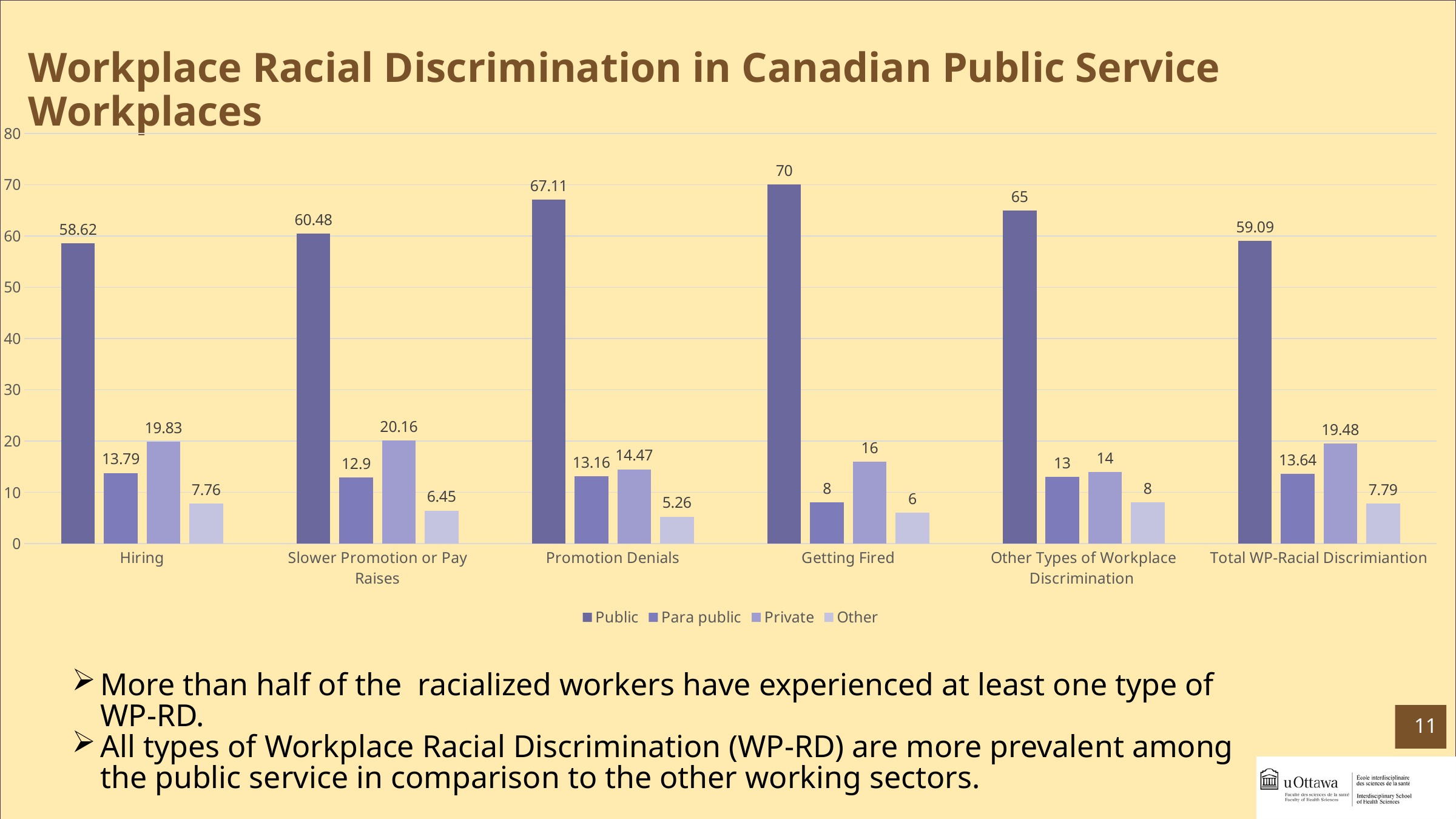
Which category has the highest Public value? Getting Fired What is the Para public value for Total WP-Racial Discrimiantion? 13.64 How many series does the legend list? 4 Which series is listed first in the legend? Public How many categories are shown on the x axis? 6 What is the difference between the Public and Para public values for Hiring? 44.83 Which is larger for Other Types of Workplace Discrimination: the Private value or the Para public value? Private Which category has the lowest Other value? Promotion Denials What kind of chart is shown on the slide? Bar chart What is the Private value for Slower Promotion or Pay Raises? 20.16 What is the Other value for Getting Fired? 6 What is the Public value for Promotion Denials? 67.11